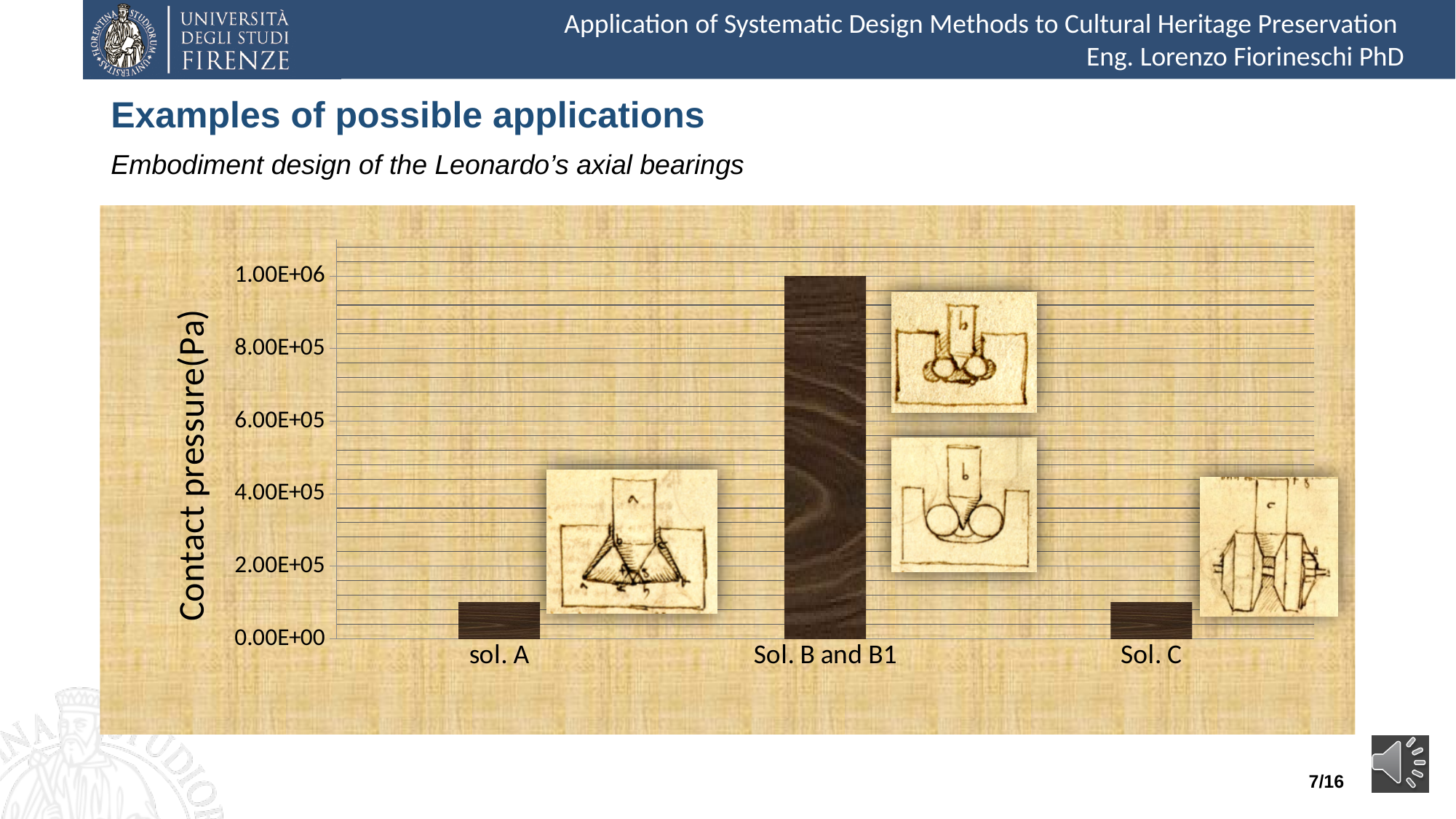
Is the value for sol. A greater or less than 2.00E+05? less How many categories are plotted on the x axis of the chart? 3 Which has a larger contact pressure, Sol. C or Sol. B and B1? Sol. B and B1 Is the value for Sol. B and B1 greater or less than 8.00E+05? greater Which category has the highest contact pressure in the chart? Sol. B and B1 What kind of chart is shown on the slide? bar chart Which has a larger contact pressure, sol. A or Sol. B and B1? Sol. B and B1 What is the label of the vertical axis of the chart? Contact pressure(Pa) What is the label of the middle category on the x axis of the chart? Sol. B and B1 Is the value for Sol. C greater or less than 2.00E+05? less What is the contact pressure for Sol. B and B1 according to the chart? 1.00E+06